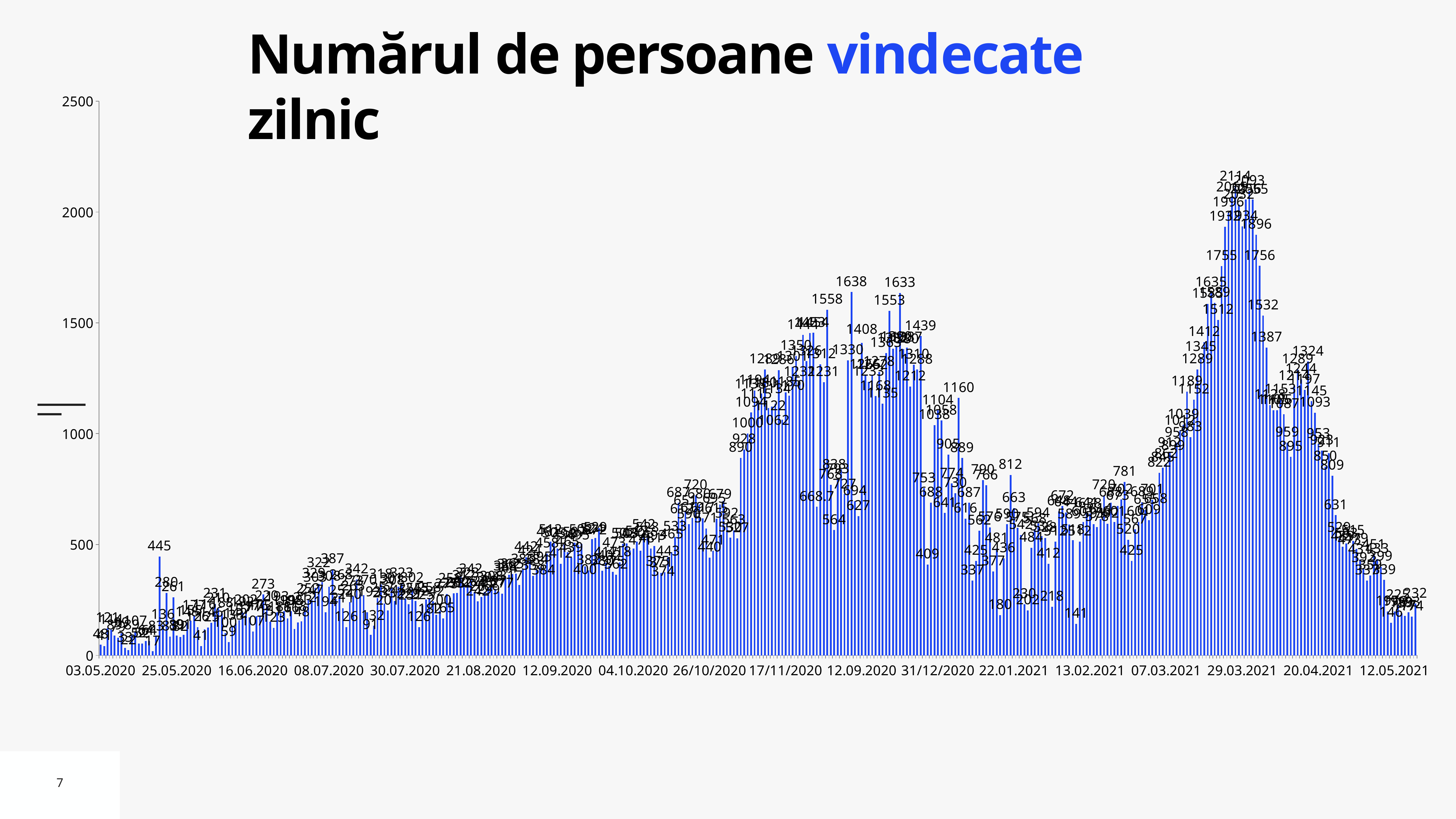
What is the highest value labelled in May 2020, near the 25.05.2020 tick? 445 Is the value of the bar at the 12.05.2021 tick greater or less than 500? less What is the highest value shown on the vertical axis? 2500 What is the difference between the labelled values 1638 and 1633? 5 What is the highest value labelled on the chart? 2114 What kind of chart is shown on the slide? bar chart What is the difference between the peak values 2114 and 1638? 476 Which is larger, the peak value 2114 or the peak value 1638? 2114 What is the value of the tallest bar between the 17/11/2020 and 31/12/2020 ticks? 1638 What is the title of the chart? Numărul de persoane vindecate zilnic Between the 29.03.2021 and 12.05.2021 ticks, do the values generally rise or fall? fall Is the value of the bar at the 17/11/2020 tick greater or less than 1000? greater